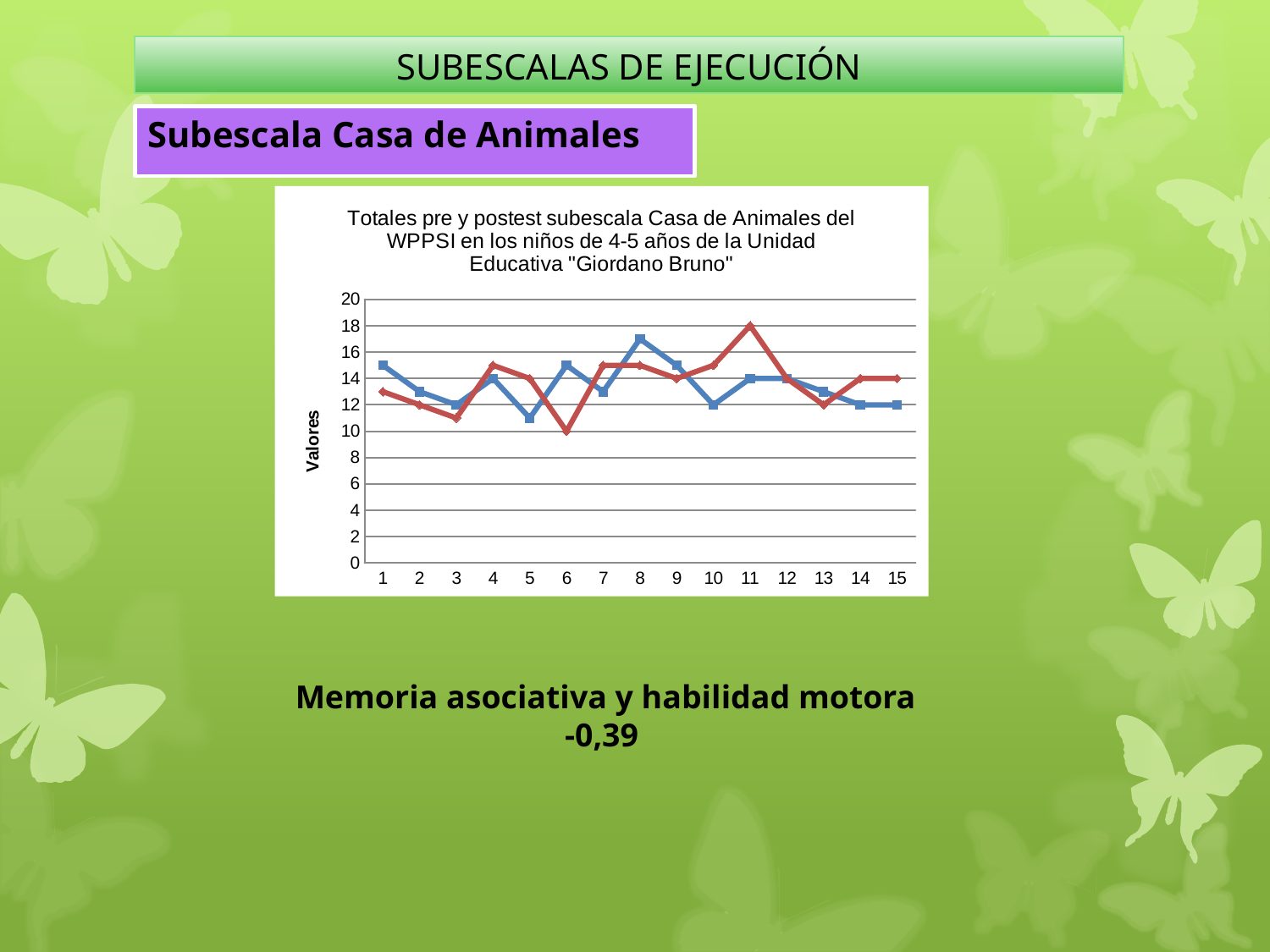
At which x-axis point does the red line reach its highest value? 11 How many points are plotted along the x axis of the chart? 15 How many lines are plotted in the chart? 2 Is the value of the blue line at point 8 greater or less than 16? greater What is the label of the vertical axis of the chart? Valores At point 6, which line has the higher value, the red line or the blue line? blue line At which x-axis point does the red line reach its lowest value? 6 At point 11, which line has the higher value, the red line or the blue line? red line What is the value of the red line at point 6? 10 What kind of chart is shown on the slide? line chart What is the value of the red line at point 11? 18 Is the value of the blue line at point 5 greater or less than 12? less